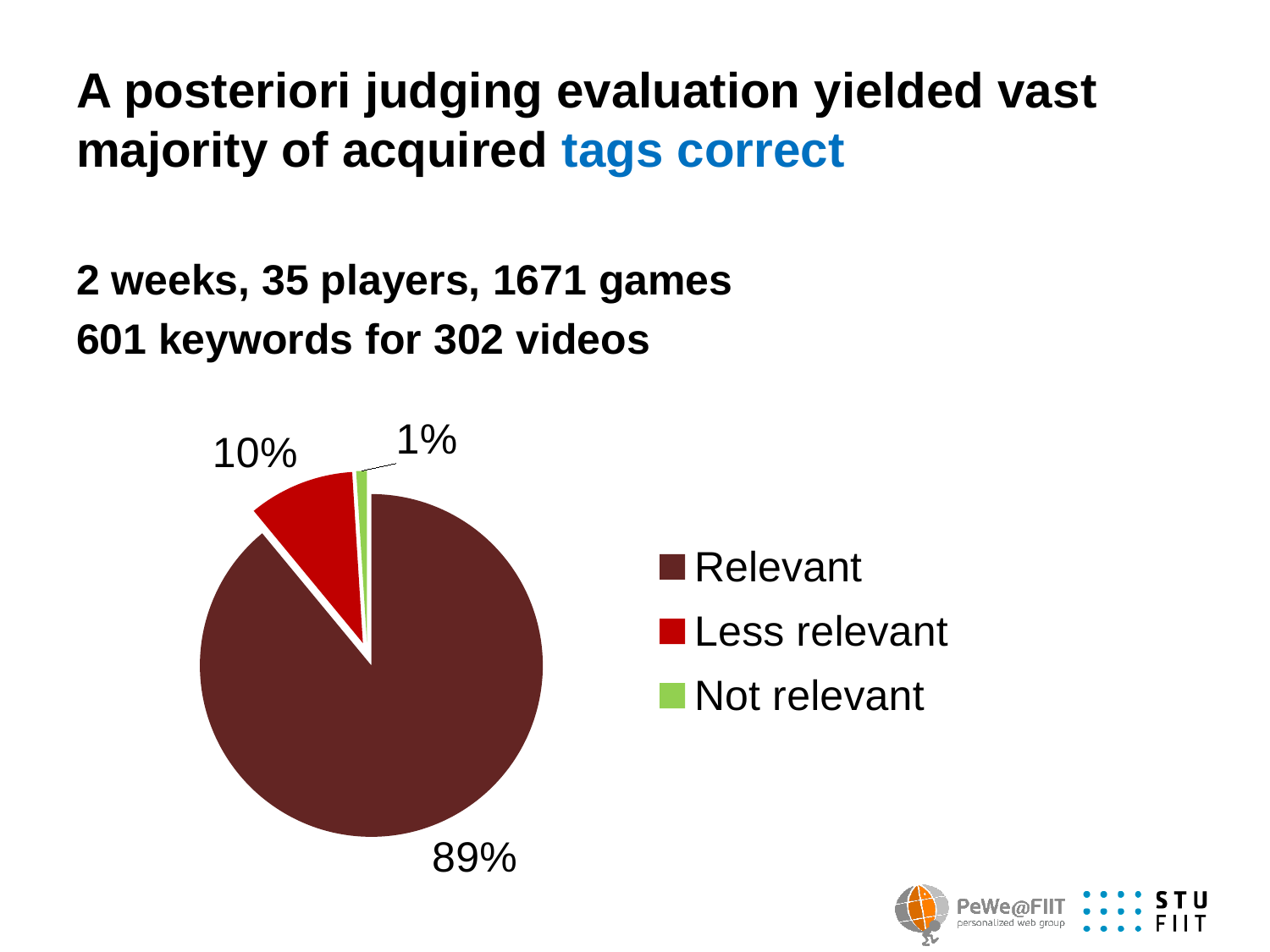
Which category has the largest slice of the pie? Relevant What is the difference in percentage points between the Relevant and Less relevant slices? 79 Which category has the smallest slice of the pie? Not relevant What colour is the Relevant slice? dark red What is the difference in percentage points between the Less relevant and Not relevant slices? 9 What share of the pie is labelled Less relevant? 10% What kind of chart is shown on the slide? pie chart What share of the pie is labelled Relevant? 89% How many categories does the legend list? 3 What colour is the Not relevant slice? green Which slice is larger, Less relevant or Not relevant? Less relevant What share of the pie is labelled Not relevant? 1%